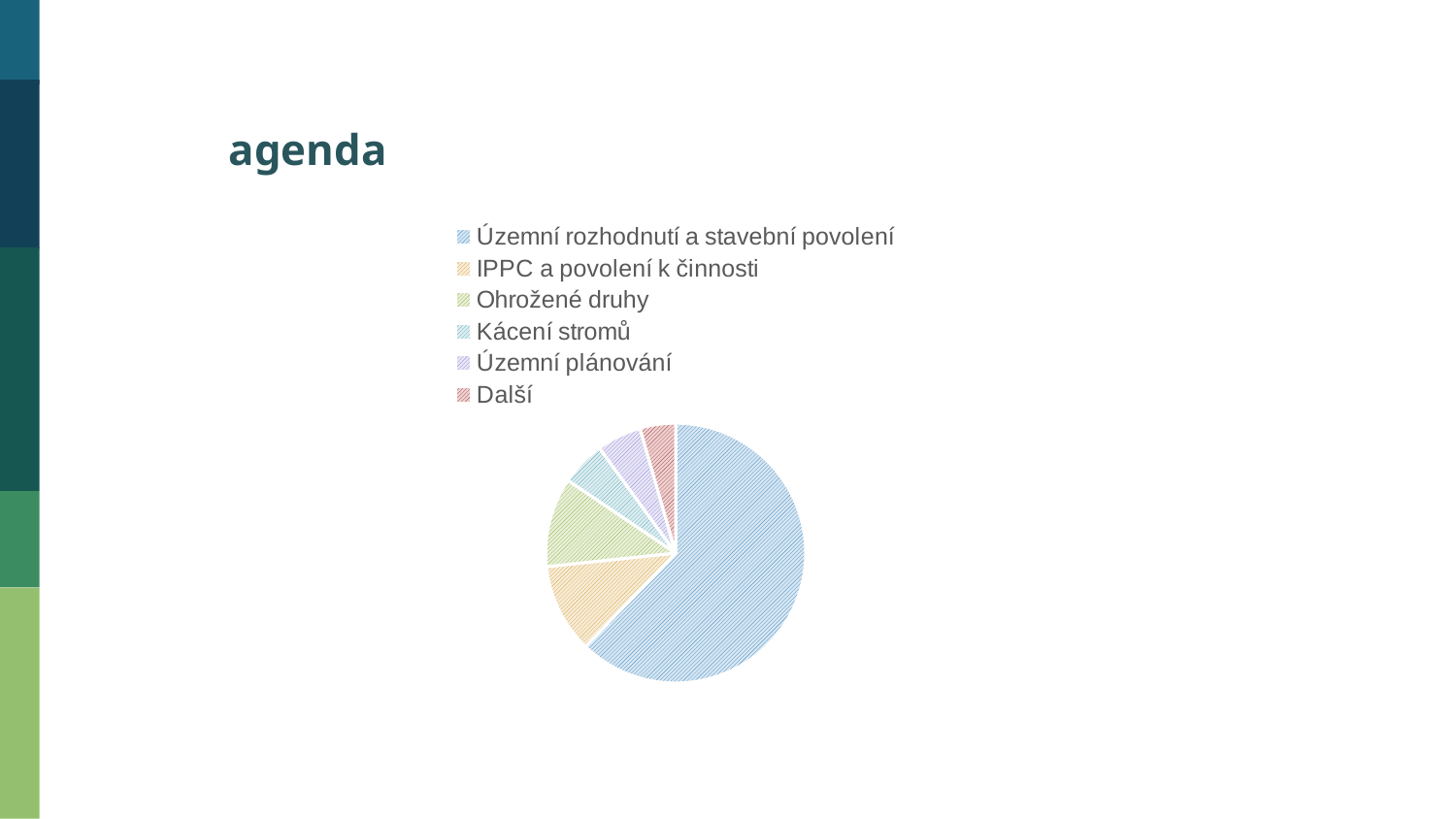
Which category has the largest slice in the pie chart? Územní rozhodnutí a stavební povolení Which slice is larger: Územní rozhodnutí a stavební povolení or Ohrožené druhy? Územní rozhodnutí a stavební povolení Is the share of the pie for Územní rozhodnutí a stavební povolení greater or less than 50%? greater How many slices does the pie chart have? 6 Which legend entry is listed first above the pie chart? Územní rozhodnutí a stavební povolení How many categories does the legend of the pie chart list? 6 Which slice is larger: Ohrožené druhy or Územní plánování? Ohrožené druhy What is the title of the slide containing the pie chart? agenda What kind of chart is shown on the slide? pie chart Which slice is larger: Územní rozhodnutí a stavební povolení or Další? Územní rozhodnutí a stavební povolení